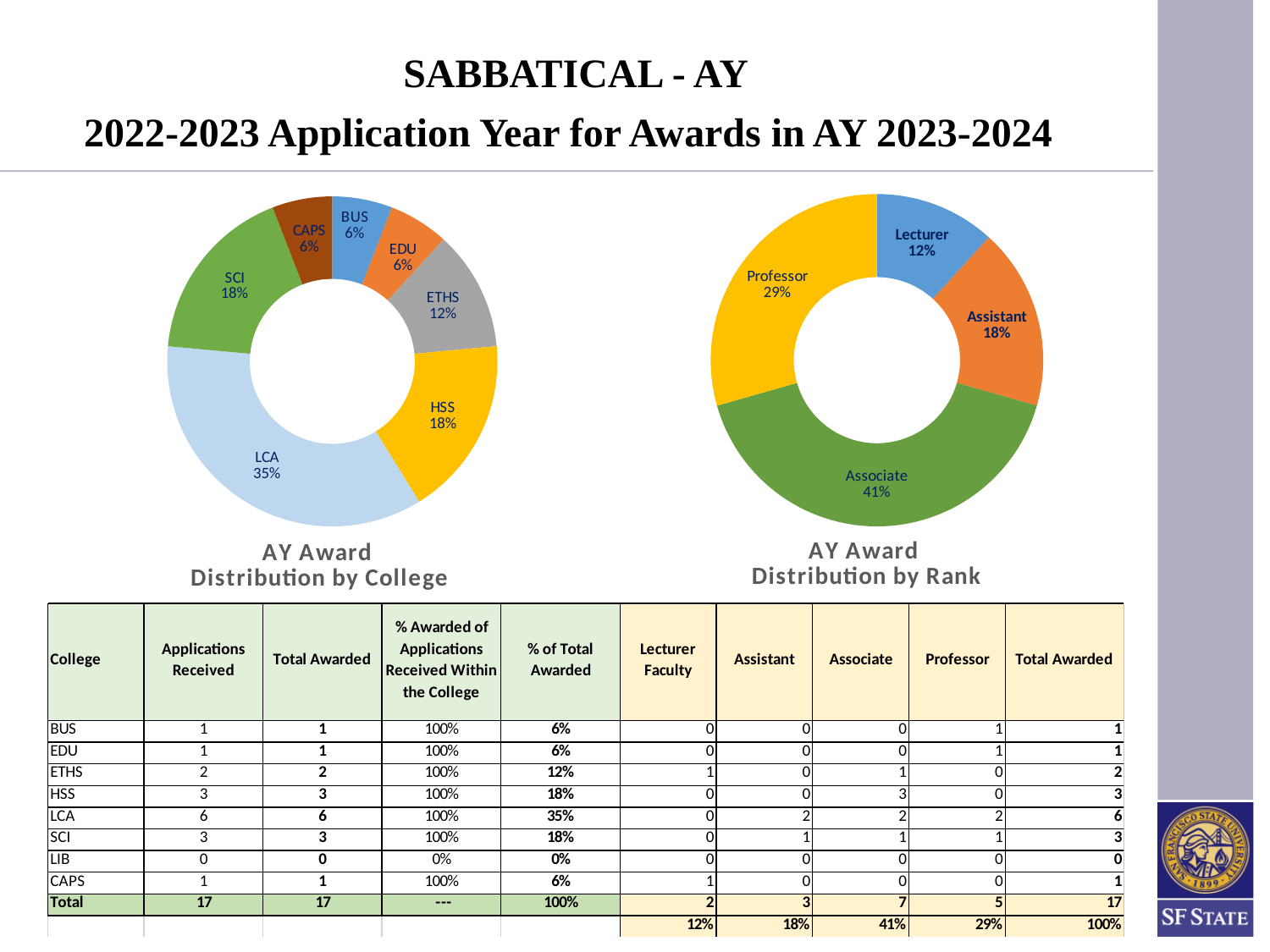
In the AY Award Distribution by Rank chart, what share does Professor have? 29% In the AY Award Distribution by College chart, what share does ETHS have? 12% In the AY Award Distribution by Rank chart, what is the difference between the Associate share and the Assistant share? 23% In the AY Award Distribution by College chart, what is the difference between the LCA share and the SCI share? 17% In the AY Award Distribution by College chart, what share does LCA have? 35% In the AY Award Distribution by College chart, how many college slices are shown? 7 In the AY Award Distribution by Rank chart, how many rank slices are shown? 4 What type of chart is the AY Award Distribution by Rank chart? Donut (pie) chart In the AY Award Distribution by Rank chart, what share does Associate have? 41% In the AY Award Distribution by College chart, which is larger, the HSS share or the EDU share? HSS In the AY Award Distribution by College chart, which college has the largest share? LCA In the AY Award Distribution by Rank chart, which rank has the smallest share? Lecturer